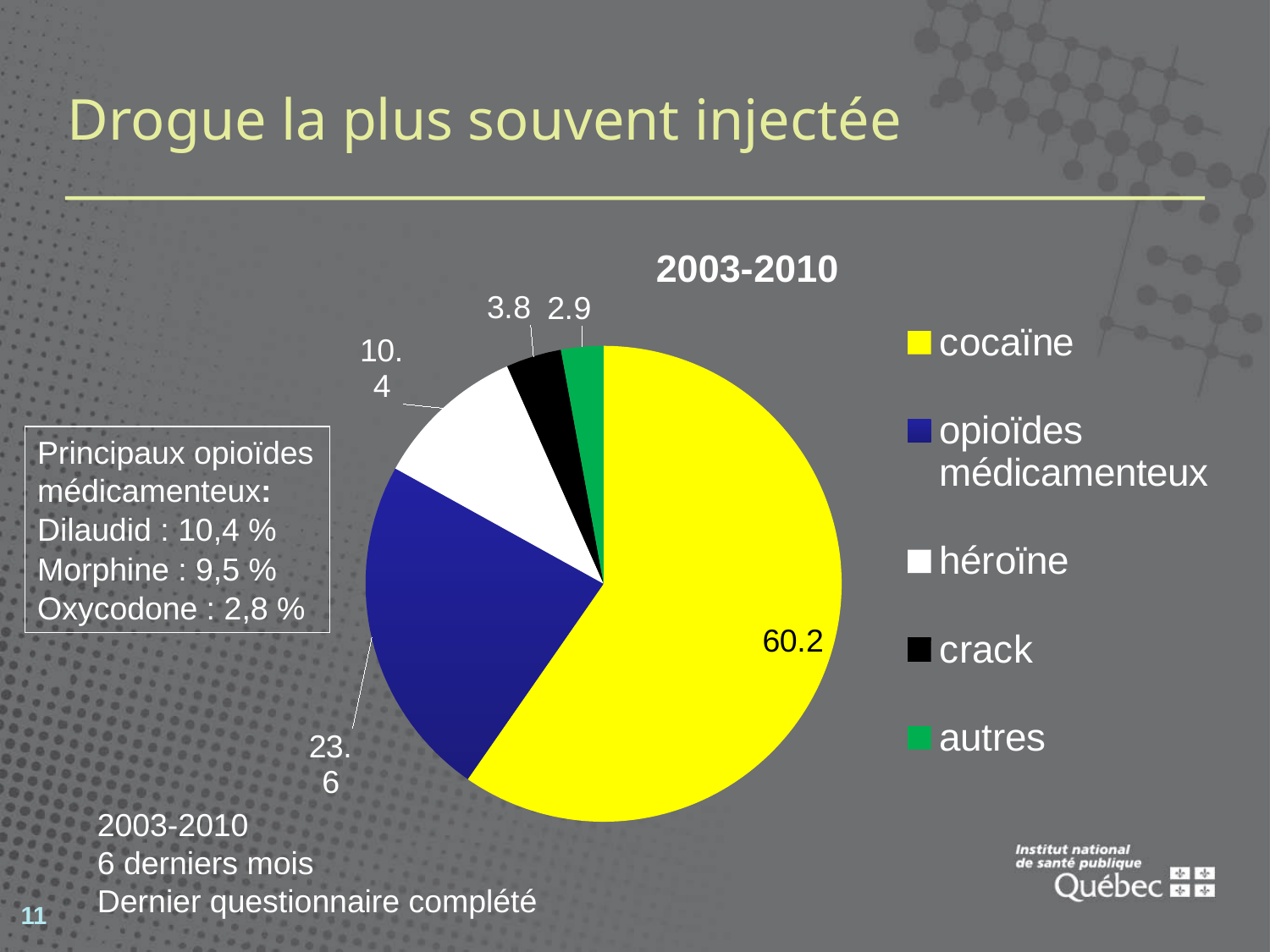
How many entries does the legend list? 5 What is the difference between the values for cocaïne and opioïdes médicamenteux? 36.6 What is the value for crack? 3.8 How many slices does the pie chart have? 5 What is the value for autres? 2.9 What is the value for cocaïne? 60.2 Which category has the largest slice? cocaïne Which category has the smallest slice? autres What is the chart's title? 2003-2010 What is the value for héroïne? 10.4 What kind of chart is shown on the slide? pie chart What is the value for opioïdes médicamenteux? 23.6